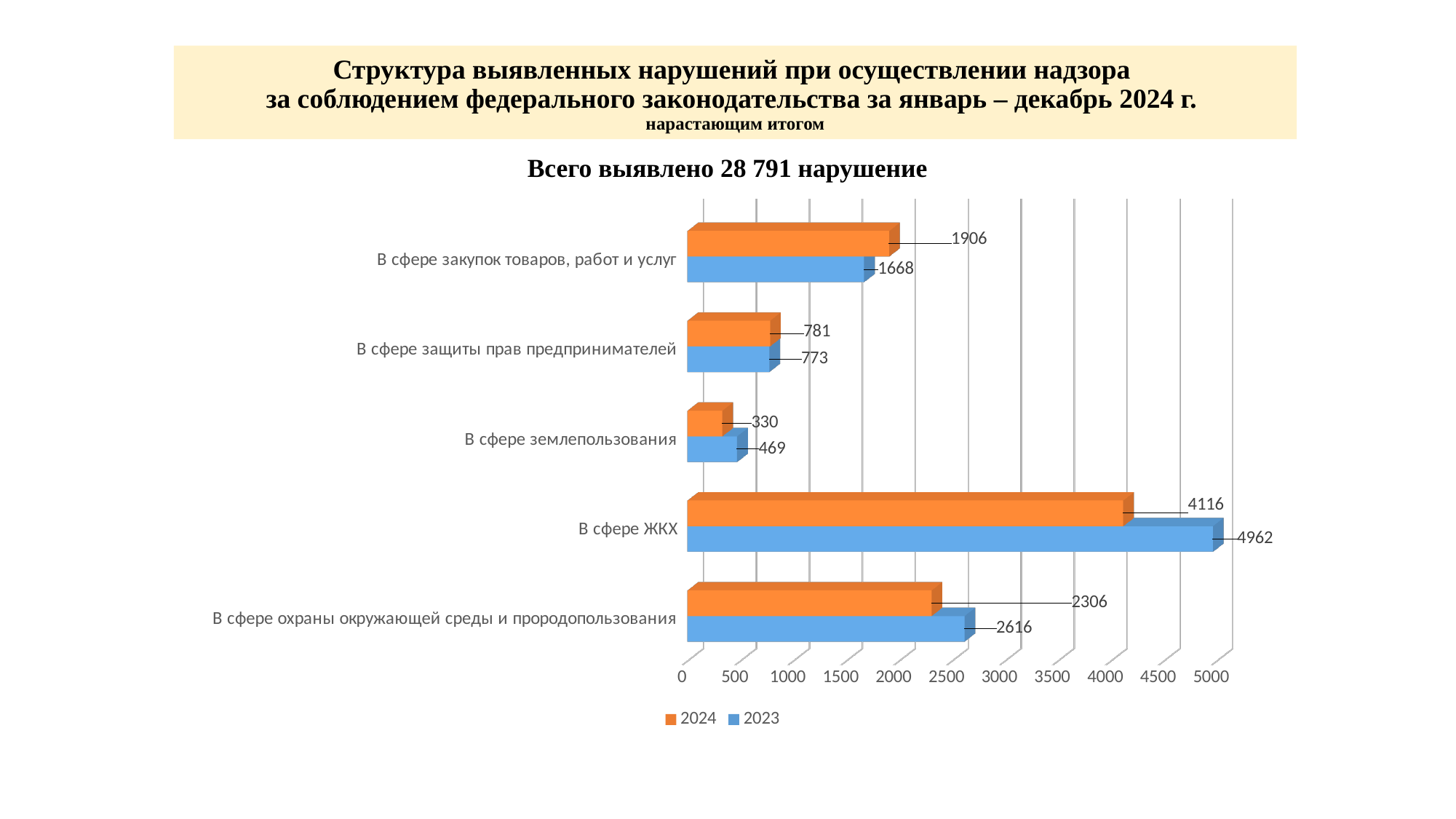
Which category has the highest 2023 value? В сфере ЖКХ What is the 2024 value for «В сфере землепользования»? 330 What is the 2023 value for «В сфере закупок товаров, работ и услуг»? 1668 Which colour represents the 2024 series in the legend? Orange Which is larger for «В сфере охраны окружающей среды и прородопользования»: the 2024 value or the 2023 value? 2023 What is the difference between the 2024 and 2023 values for «В сфере защиты прав предпринимателей»? 8 What kind of chart is shown on the slide? Bar chart How many series does the legend list? 2 Which category has the lowest 2024 value? В сфере землепользования What is the 2024 value for «В сфере ЖКХ»? 4116 How many categories are shown on the chart? 5 What is the difference between the 2023 and 2024 values for «В сфере ЖКХ»? 846